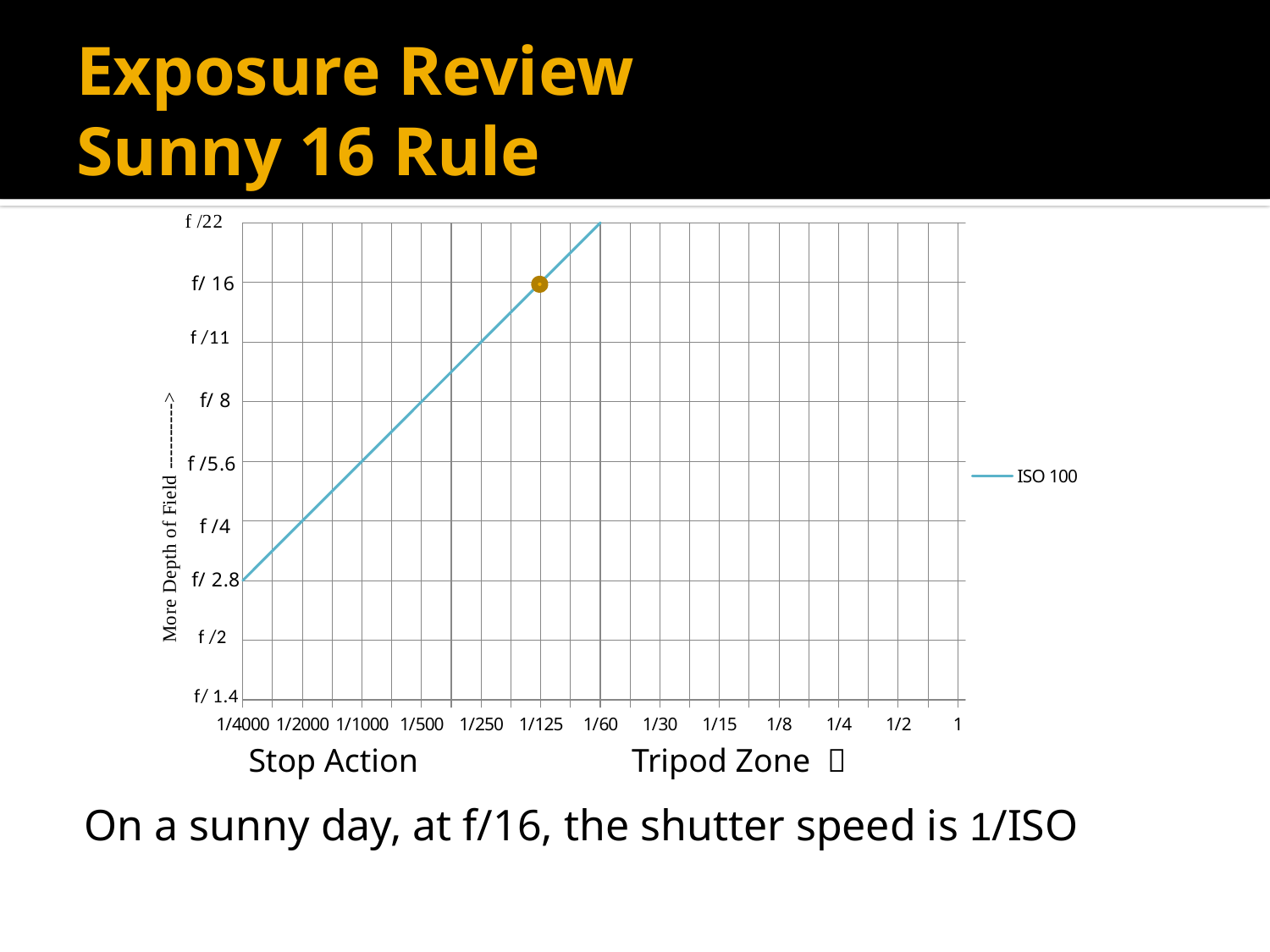
Does the ISO 100 line rise or fall as the shutter speed moves from 1/4000 toward 1/60? rise What aperture does the ISO 100 line show at a shutter speed of 1/500? f/ 8 What is the name of the series shown in the legend? ISO 100 What aperture does the ISO 100 line show at a shutter speed of 1/4000? f/ 2.8 What aperture does the ISO 100 line reach at a shutter speed of 1/125? f/ 16 At which shutter speed is the highlighted marker on the ISO 100 line placed? 1/125 What aperture does the ISO 100 line reach at a shutter speed of 1/60? f /22 What kind of chart is shown on the slide? line chart How many shutter speed categories are labelled on the x axis? 13 How many series does the legend list? 1 What aperture does the ISO 100 line show at a shutter speed of 1/1000? f /5.6 Which shutter speed has the larger aperture value on the ISO 100 line, 1/250 or 1/1000? 1/250